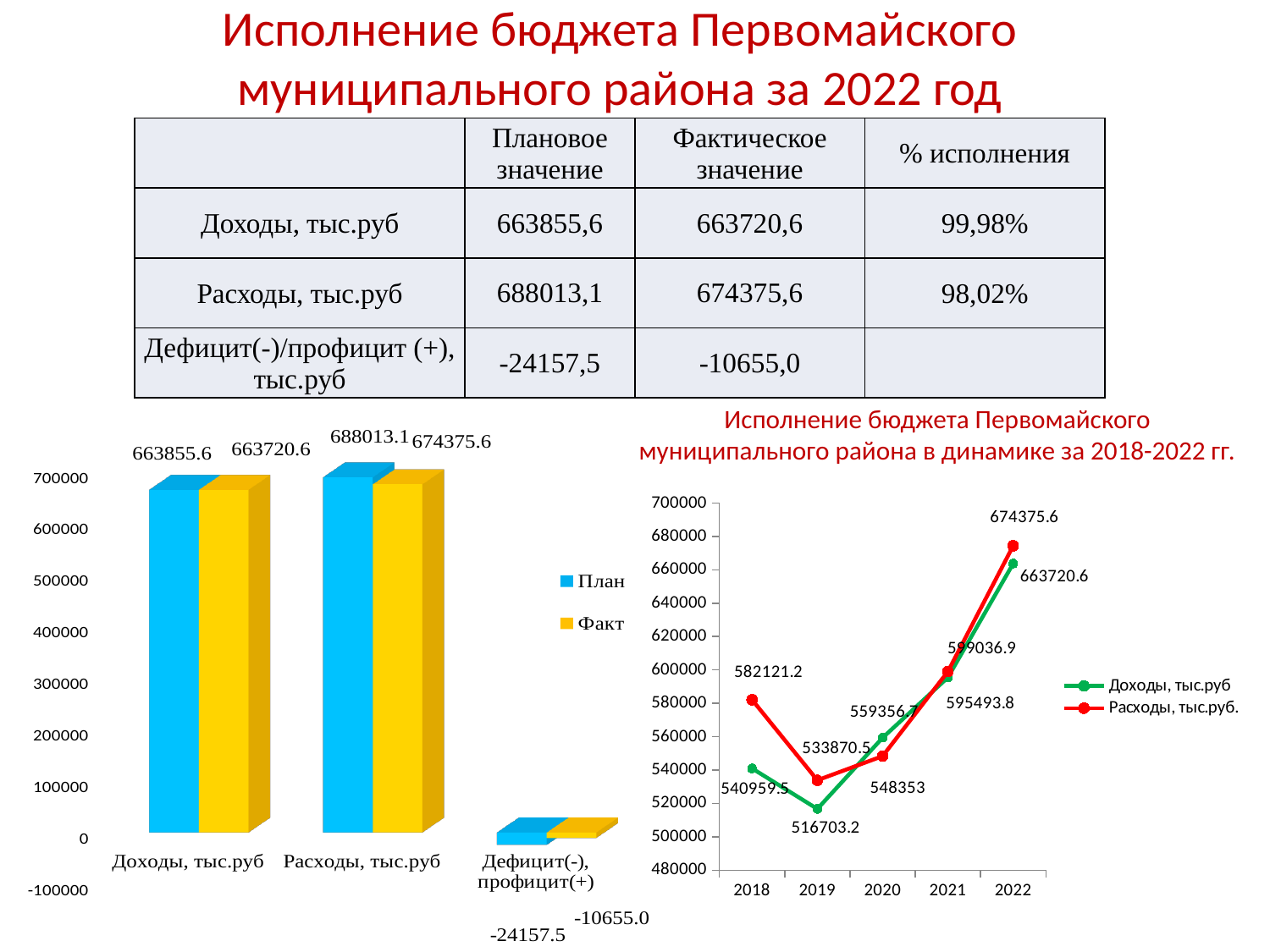
In the left bar chart, what is the План value for Доходы, тыс.руб? 663855.6 In the left bar chart, what is the difference between the План and Факт values for Расходы, тыс.руб? 13637.5 In the chart titled 'Исполнение бюджета Первомайского муниципального района в динамике за 2018-2022 гг.', which year has the lowest value for Доходы, тыс.руб? 2019 What kind of chart is the chart on the left of the slide? Bar chart In the chart titled 'Исполнение бюджета Первомайского муниципального района в динамике за 2018-2022 гг.', do the values for Расходы, тыс.руб. rise or fall from 2019 to 2022? Rise In the left bar chart, how many series does the legend list? 2 In the chart titled 'Исполнение бюджета Первомайского муниципального района в динамике за 2018-2022 гг.', what is the value of Расходы, тыс.руб. in 2018? 582121.2 In the left bar chart, what is the Факт value for Расходы, тыс.руб? 674375.6 In the chart titled 'Исполнение бюджета Первомайского муниципального района в динамике за 2018-2022 гг.', which is larger in 2018: Доходы, тыс.руб or Расходы, тыс.руб.? Расходы, тыс.руб. In the chart titled 'Исполнение бюджета Первомайского муниципального района в динамике за 2018-2022 гг.', how many years are plotted on the x axis? 5 In the chart titled 'Исполнение бюджета Первомайского муниципального района в динамике за 2018-2022 гг.', what is the value of Доходы, тыс.руб in 2019? 516703.2 In the left bar chart, what is the Факт value for Дефицит(-), профицит(+)? -10655.0